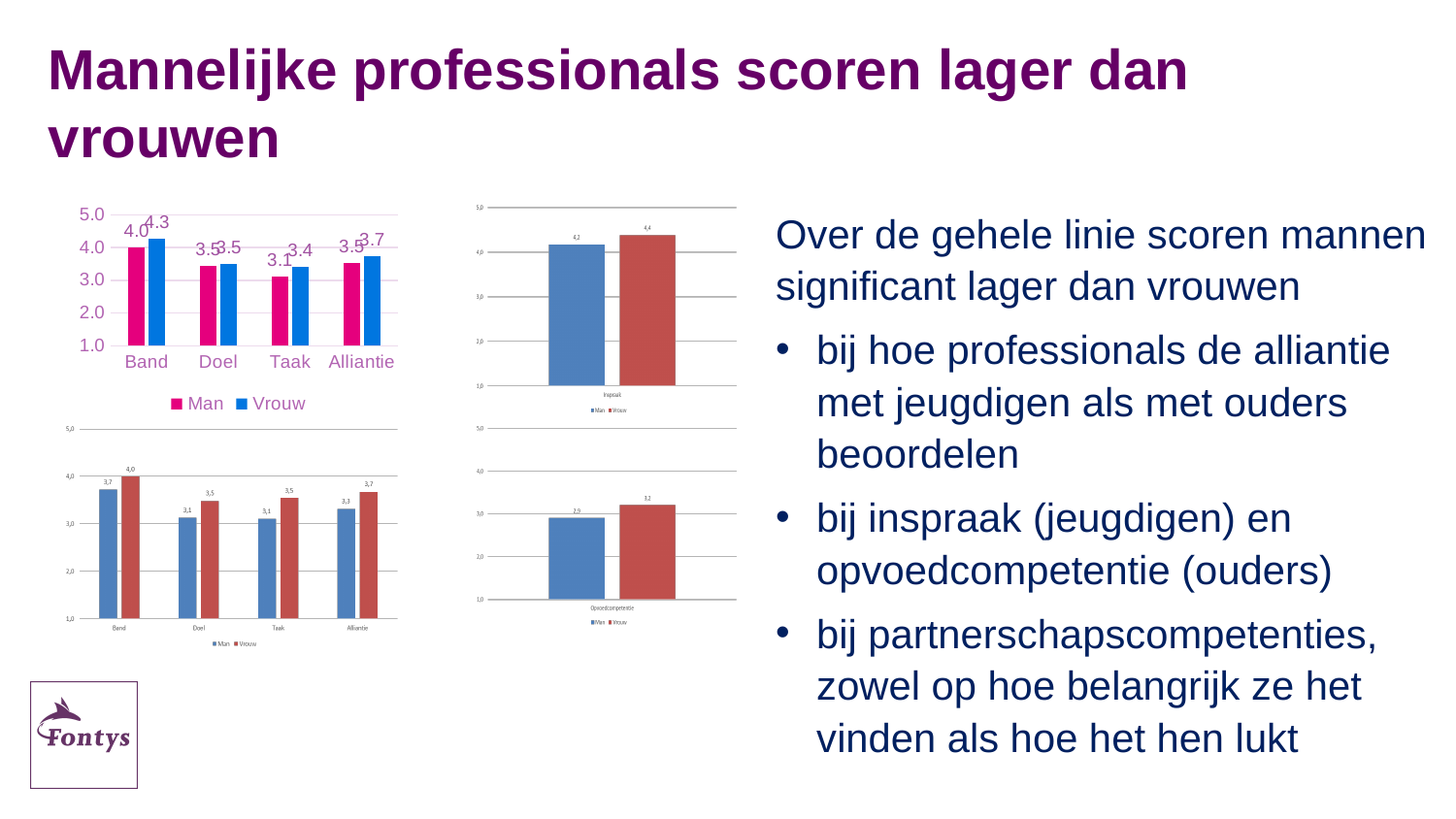
In the bottom-left chart, what is the value for Vrouw in the Band category? 4,0 In the bottom-left chart, what is the value for Man in the Alliantie category? 3,3 In the top-left chart, what is the value for Vrouw in the Taak category? 3.4 What kind of chart is the top-left chart? Bar chart In the top-left chart, what is the value for Man in the Band category? 4.0 In the top-middle chart (Inspraak), what is the value for Vrouw? 4,4 How many categories are shown on the x axis of the bottom-left chart? 4 In the top-left chart, which category has the highest value for Vrouw? Band In the bottom-middle chart (Opvoedcompetentie), what is the value for Man? 2,9 How many series does the legend of the top-left chart list? 2 In the top-left chart, what is the difference between the Vrouw and Man values for Alliantie? 0.2 In the bottom-middle chart (Opvoedcompetentie), which is larger, the value for Man or for Vrouw? Vrouw